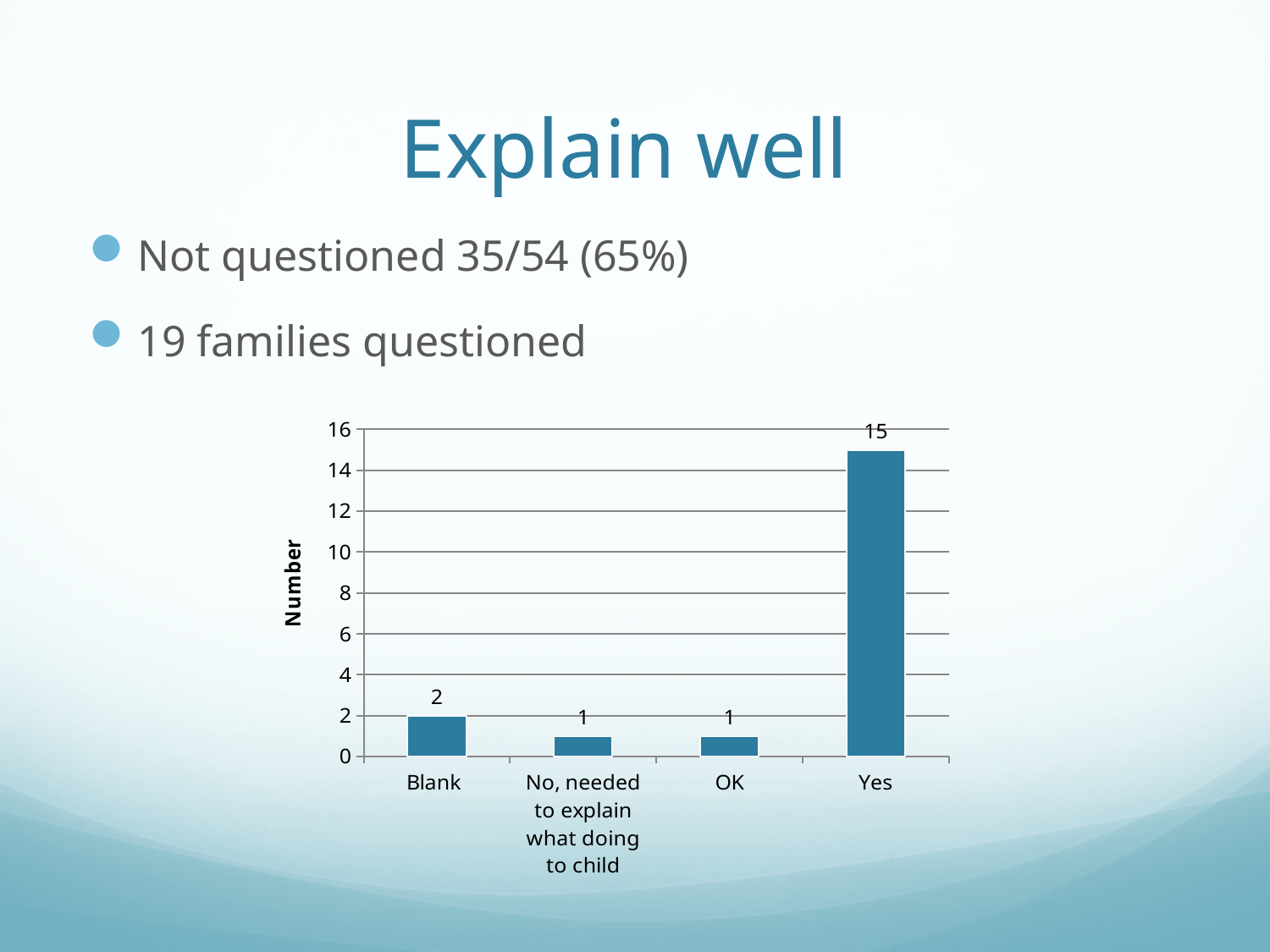
What is the value for Yes? 15 What is the value for Blank? 2 What is the difference between the values for Yes and Blank? 13 How many categories are shown on the x axis? 4 What is the total of all four bar values? 19 Which is larger, the value for Blank or the value for OK? Blank Which category has the highest value? Yes Is the value for Yes greater or less than 14? greater What is the value for OK? 1 What is the label of the vertical axis? Number What kind of chart is shown on the slide? bar chart What is the value for 'No, needed to explain what doing to child'? 1